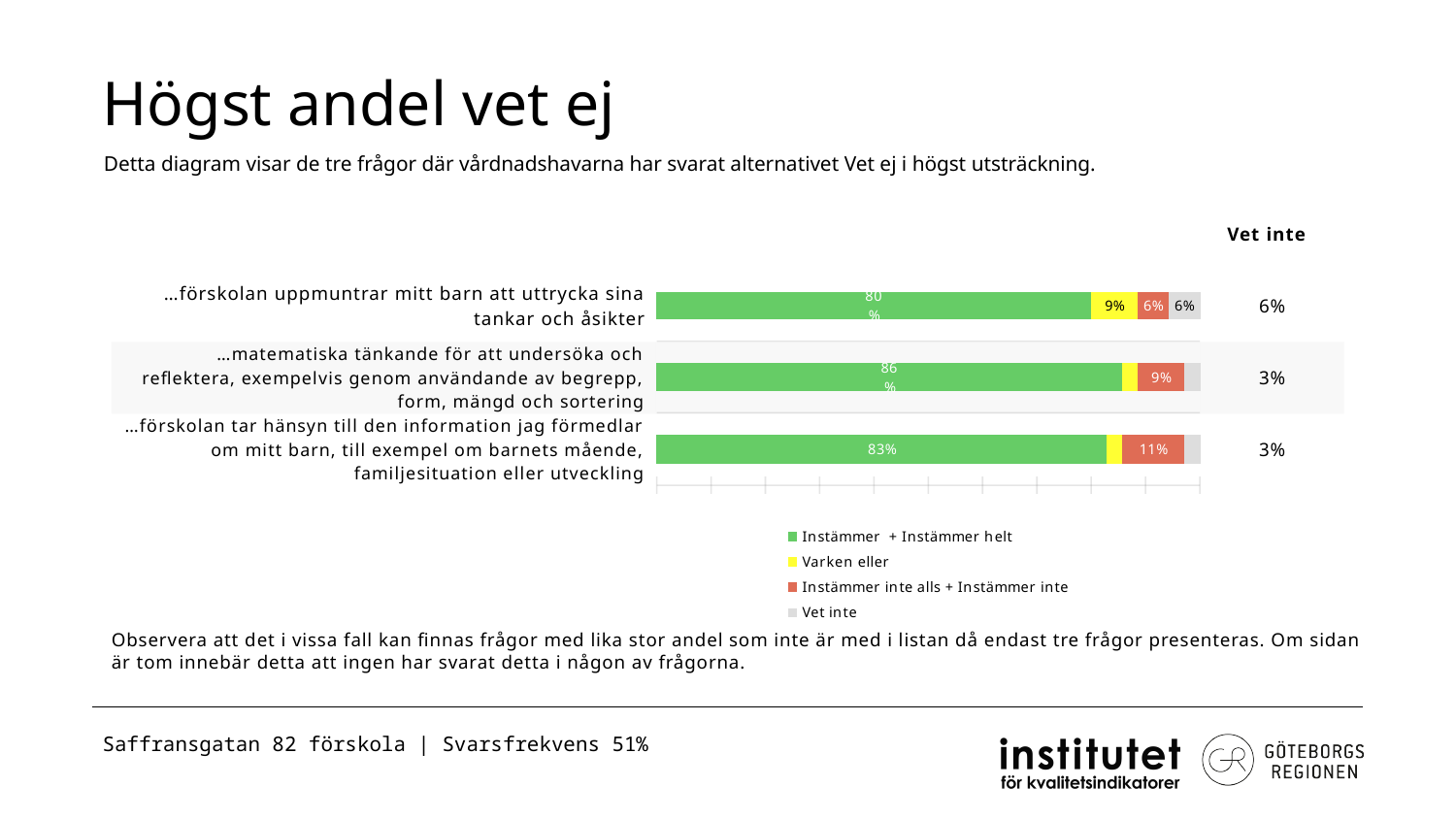
What kind of chart is shown on the slide? stacked bar chart What is the 'Vet inte' value for '…förskolan uppmuntrar mitt barn att uttrycka sina tankar och åsikter'? 6% How many series does the legend list? 4 How many questions (categories) are shown in the chart? 3 What is the difference between the 'Instämmer + Instämmer helt' values for the mathematical thinking question (86%) and the question about expressing thoughts and opinions (80%)? 6% What is the 'Instämmer + Instämmer helt' value for '…förskolan uppmuntrar mitt barn att uttrycka sina tankar och åsikter'? 80% Which is larger: the 'Instämmer inte alls + Instämmer inte' value for the mathematical thinking question or for the question about taking into account information about the child? the question about taking into account information about the child (11%) What is the 'Instämmer + Instämmer helt' value for '…matematiska tänkande för att undersöka och reflektera, exempelvis genom användande av begrepp, form, mängd och sortering'? 86% Which question has the highest 'Instämmer + Instämmer helt' share? …matematiska tänkande för att undersöka och reflektera, exempelvis genom användande av begrepp, form, mängd och sortering What is the 'Instämmer inte alls + Instämmer inte' value for '…förskolan tar hänsyn till den information jag förmedlar om mitt barn, till exempel om barnets mående, familjesituation eller utveckling'? 11% Which legend entry is shown in grey? Vet inte Which question has the highest 'Vet inte' share? …förskolan uppmuntrar mitt barn att uttrycka sina tankar och åsikter